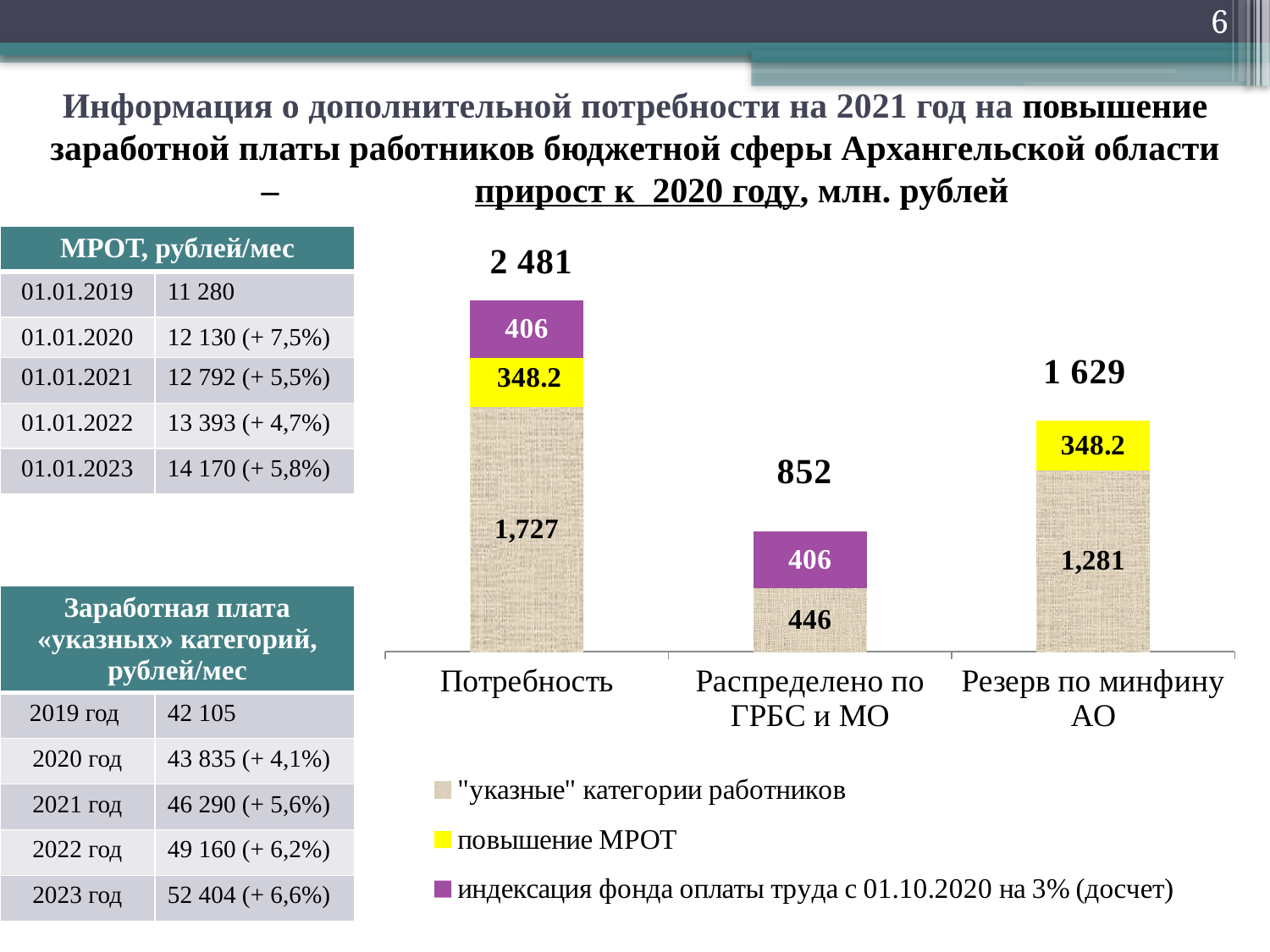
Which category has the lowest total? Распределено по ГРБС и МО What is the total of the stacked bar for Потребность? 2 481 Which category has the highest total? Потребность What is the value of the повышение МРОТ segment for Резерв по минфину АО? 348.2 How many series does the chart legend list? 3 What is the value of the индексация фонда оплаты труда segment for Распределено по ГРБС и МО? 406 Which is larger: the "указные" категории работников value for Распределено по ГРБС и МО or for Резерв по минфину АО? Резерв по минфину АО What is the difference between the "указные" категории работников values for Потребность and Резерв по минфину АО? 446 How many categories are shown on the x axis of the chart? 3 What type of chart is shown on the slide? stacked bar chart What is the value of the "указные" категории работников segment for Потребность? 1,727 What is the total of the stacked bar for Резерв по минфину АО? 1 629